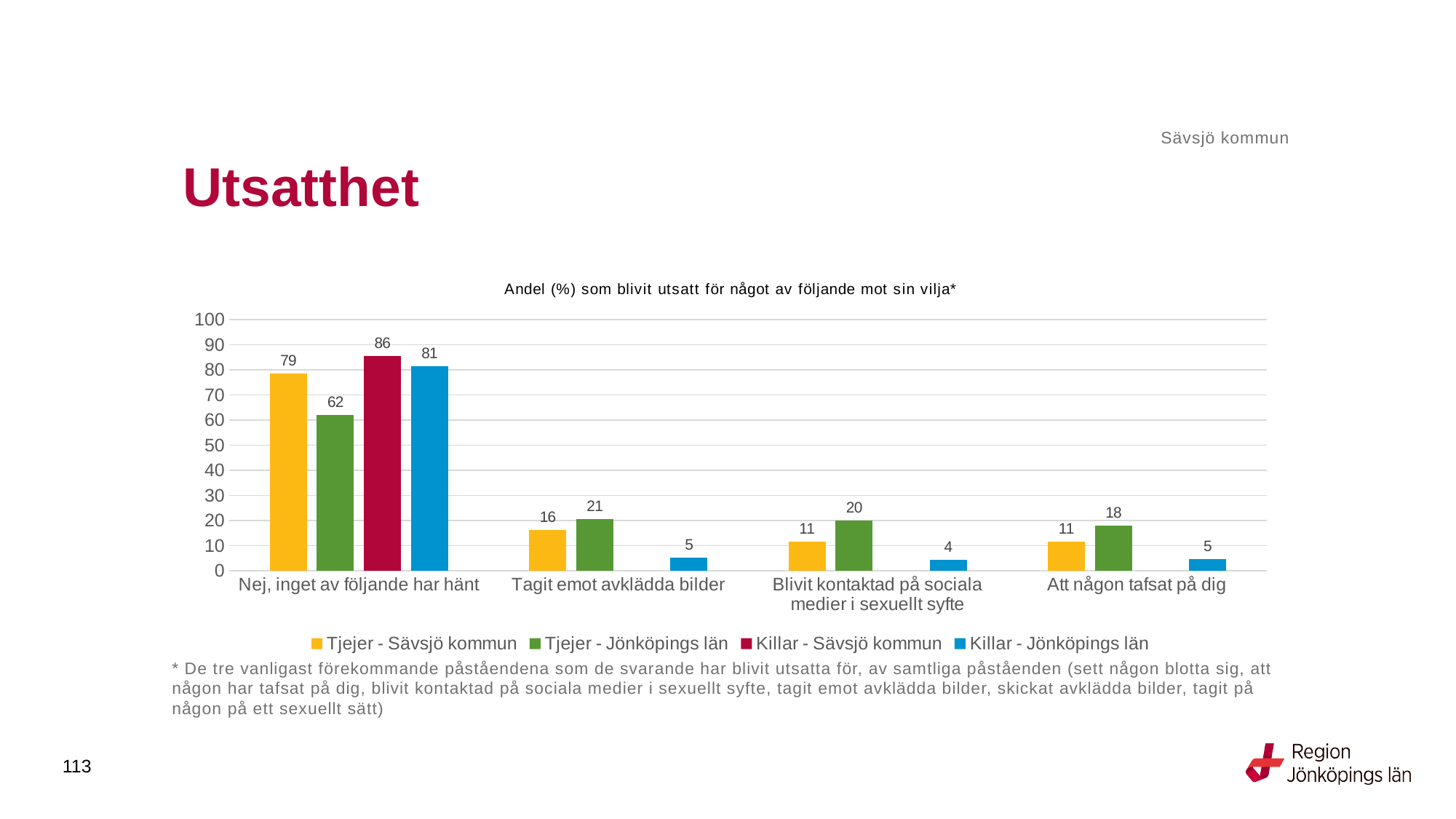
What is the value for Killar - Jönköpings län in the category 'Blivit kontaktad på sociala medier i sexuellt syfte'? 4 What kind of chart is shown on the slide? bar chart What is the title of the chart? Andel (%) som blivit utsatt för något av följande mot sin vilja* What is the value for Tjejer - Jönköpings län in the category 'Tagit emot avklädda bilder'? 21 How many categories are shown on the x axis? 4 Which series has the lowest value in the category 'Tagit emot avklädda bilder'? Killar - Jönköpings län How many series does the legend list? 4 What is the value for Killar - Sävsjö kommun in the category 'Nej, inget av följande har hänt'? 86 What is the difference between Tjejer - Sävsjö kommun and Tjejer - Jönköpings län in the category 'Nej, inget av följande har hänt'? 17 Which series has the highest value in the category 'Nej, inget av följande har hänt'? Killar - Sävsjö kommun In the category 'Blivit kontaktad på sociala medier i sexuellt syfte', which is larger: Tjejer - Sävsjö kommun or Tjejer - Jönköpings län? Tjejer - Jönköpings län What is the value for Tjejer - Sävsjö kommun in the category 'Att någon tafsat på dig'? 11